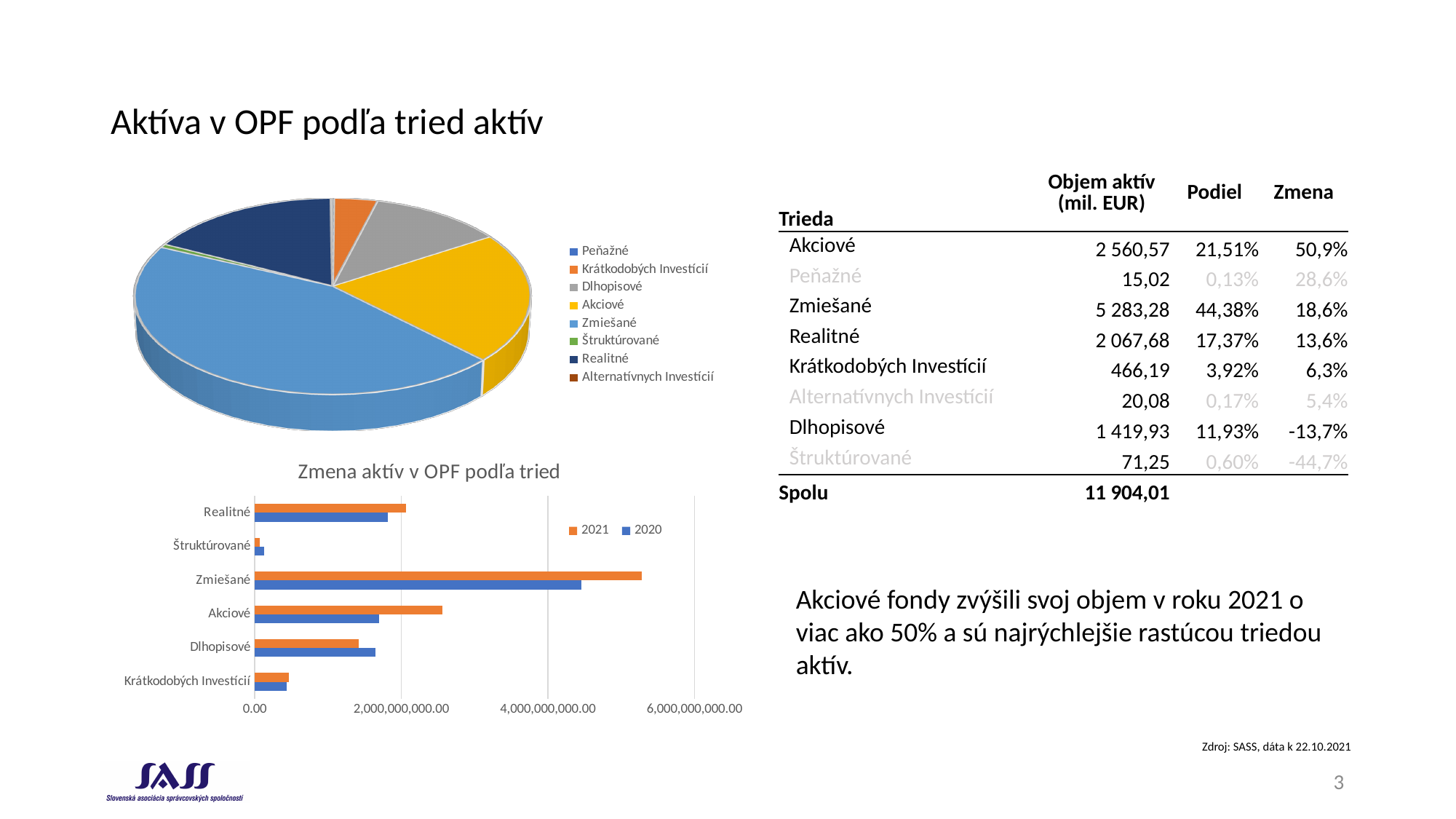
What kind of chart is the top-left chart on the slide? pie chart In 'Zmena aktív v OPF podľa tried', which is larger for Dlhopisové: the 2020 value or the 2021 value? 2020 What kind of chart is 'Zmena aktív v OPF podľa tried'? bar chart In the pie chart, which slice is larger: Zmiešané or Akciové? Zmiešané What is the title of the bar chart at the bottom left of the slide? Zmena aktív v OPF podľa tried In 'Zmena aktív v OPF podľa tried', which category has the lowest 2021 value? Štruktúrované How many categories are shown in the chart 'Zmena aktív v OPF podľa tried'? 6 How many series does the legend of 'Zmena aktív v OPF podľa tried' list? 2 How many entries does the legend of the pie chart list? 8 In 'Zmena aktív v OPF podľa tried', is the 2021 value for Zmiešané greater or less than 4,000,000,000.00? greater In 'Zmena aktív v OPF podľa tried', which category has the highest 2021 value? Zmiešané In the pie chart, which category has the largest slice? Zmiešané